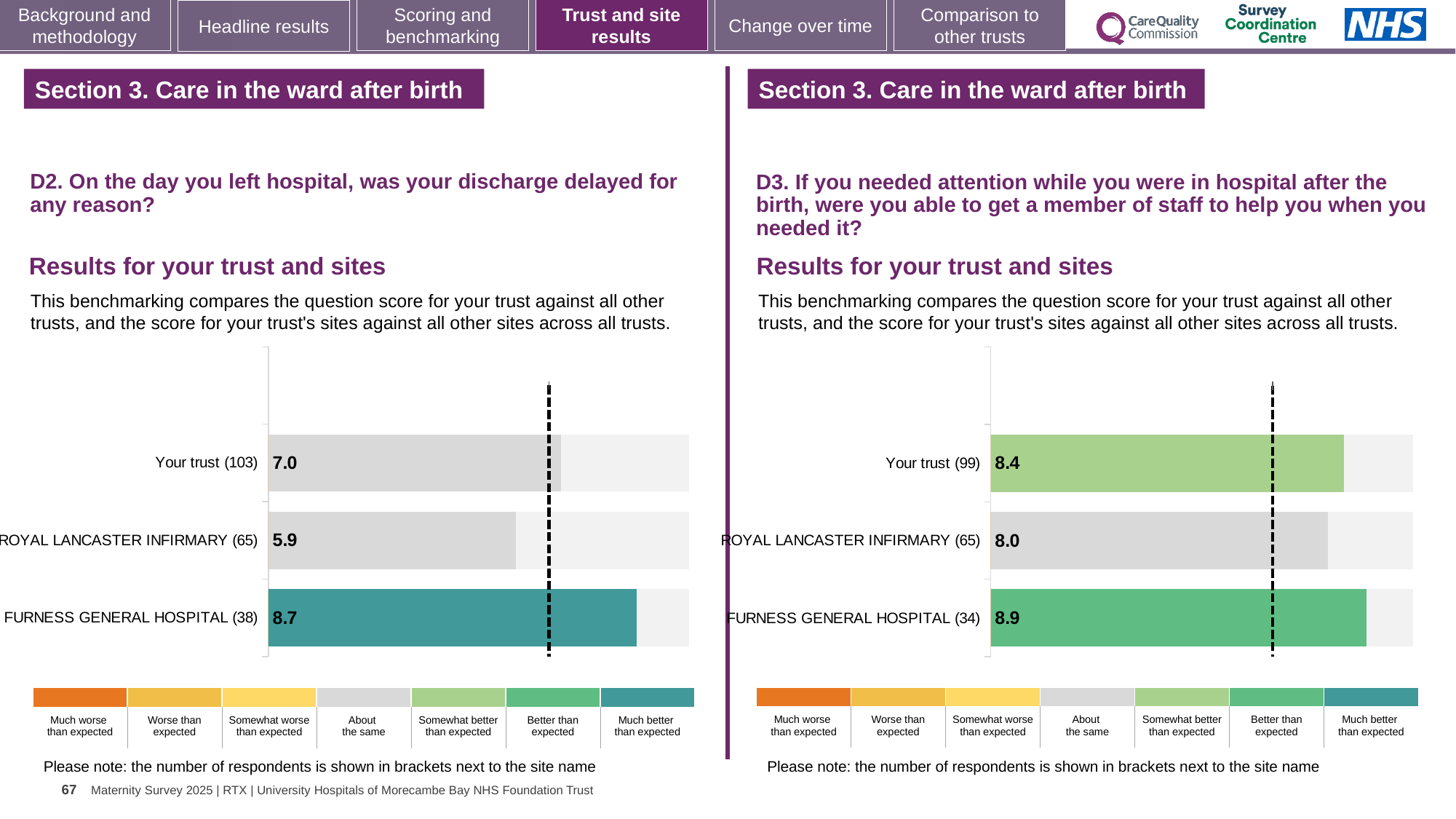
In the D2 chart (left), what is the difference between the scores for Furness General Hospital and Royal Lancaster Infirmary? 2.8 In the D3 chart (right), which has the higher score, Your trust or Royal Lancaster Infirmary? Your trust In the D2 chart (left), what is the score for Your trust? 7.0 In the D3 chart (right), what is the difference between the scores for Your trust and Furness General Hospital? 0.5 In the D3 chart (right), what is the score for Furness General Hospital? 8.9 In the D3 chart (right), what is the score for Royal Lancaster Infirmary? 8.0 In the D2 chart (left), what is the score for Royal Lancaster Infirmary? 5.9 In the D2 chart (left), which site or trust has the lowest score? Royal Lancaster Infirmary How many bars are plotted in the D3 chart (right)? 3 In the D3 chart (right), how many respondents are shown in brackets for Your trust? 99 What type of chart is used in the D2 chart (left)? Bar chart In the D2 chart (left), which site or trust has the highest score? Furness General Hospital